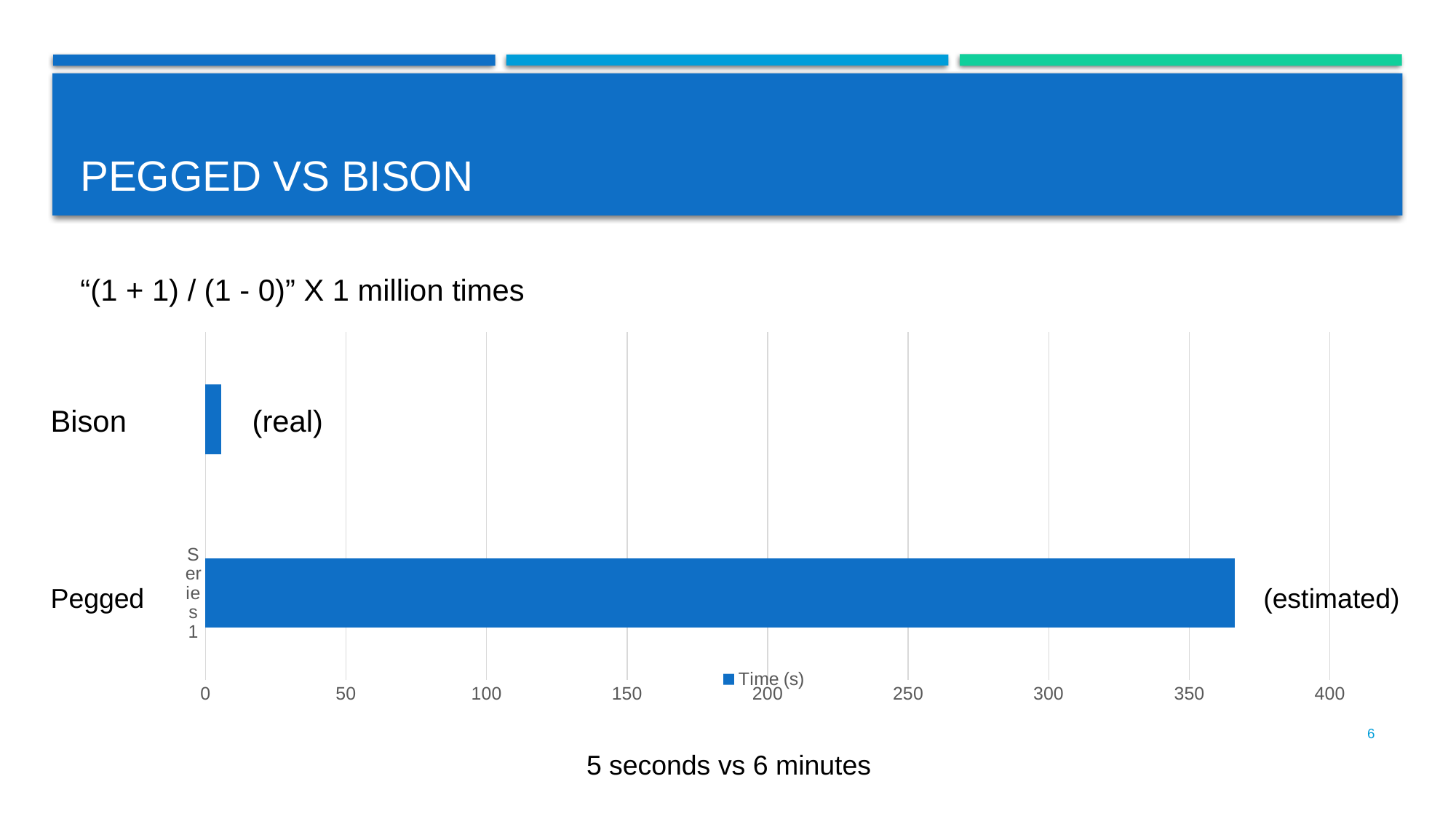
How many categories are plotted in the chart? 2 Which category has the highest Time (s) value? Pegged What kind of chart is shown on the slide? bar chart What is the name of the series shown in the chart legend? Time (s) How many series does the chart legend list? 1 What is the maximum value shown on the horizontal axis of the chart? 400 Which category has the lowest Time (s) value? Bison Is the Time (s) value for Pegged greater or less than 400? less Is the Time (s) value for Pegged greater or less than 350? greater Which has a larger Time (s) value, Pegged or Bison? Pegged Is the Time (s) value for Bison greater or less than 50? less